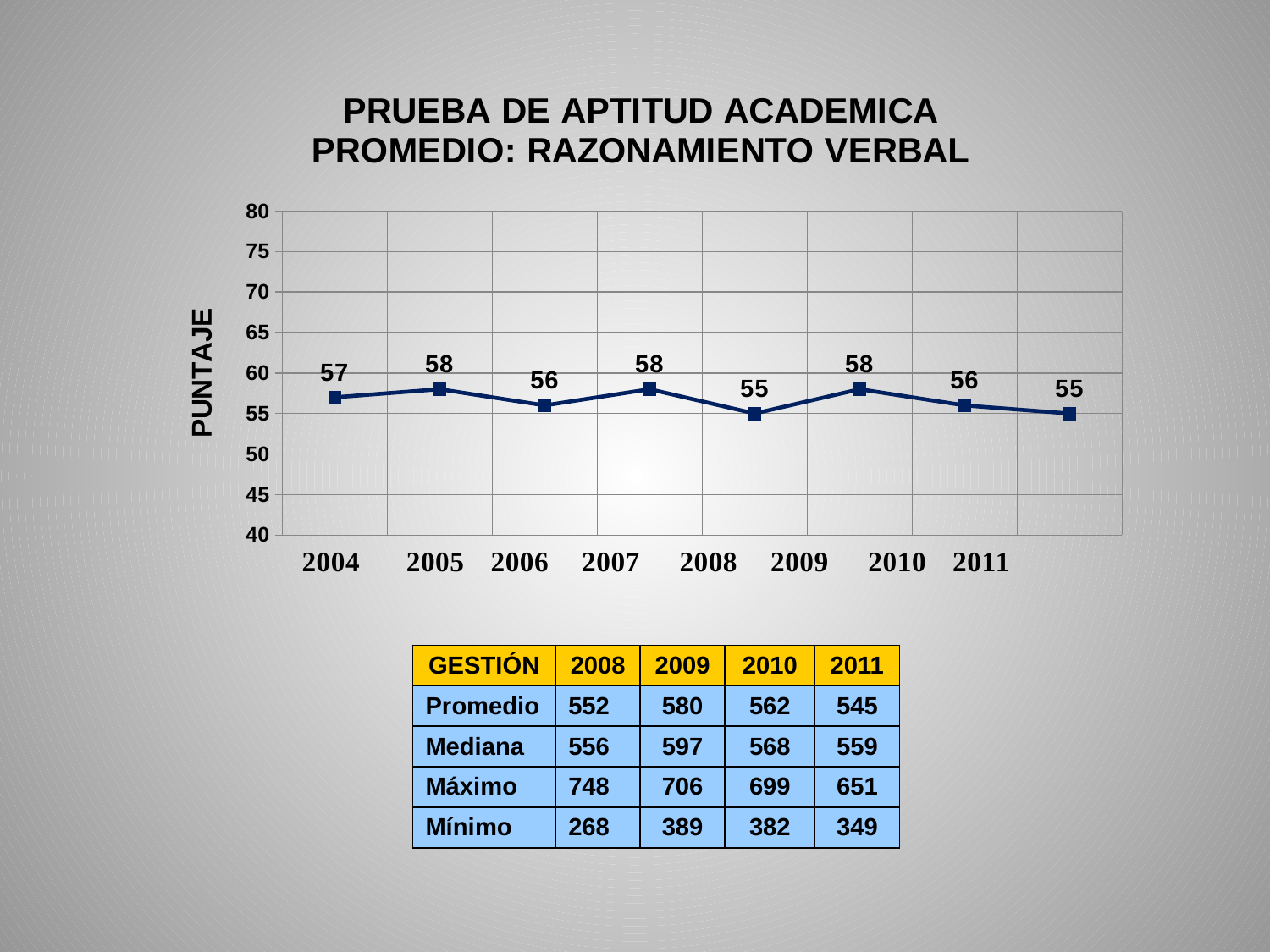
What is the highest value plotted on the line chart? 58 What is the value plotted for 2011? 55 How many years are plotted on the chart? 8 Is the value for 2007 greater or less than 60? less What is the difference between the values for 2005 and 2008? 3 What kind of chart is shown on the slide? line chart What is the lowest value plotted on the line chart? 55 What is the value plotted for 2009? 58 Which year has the larger value, 2005 or 2006? 2005 What is the label on the vertical axis of the chart? PUNTAJE What is the value plotted for 2004? 57 What is the value plotted for 2008? 55